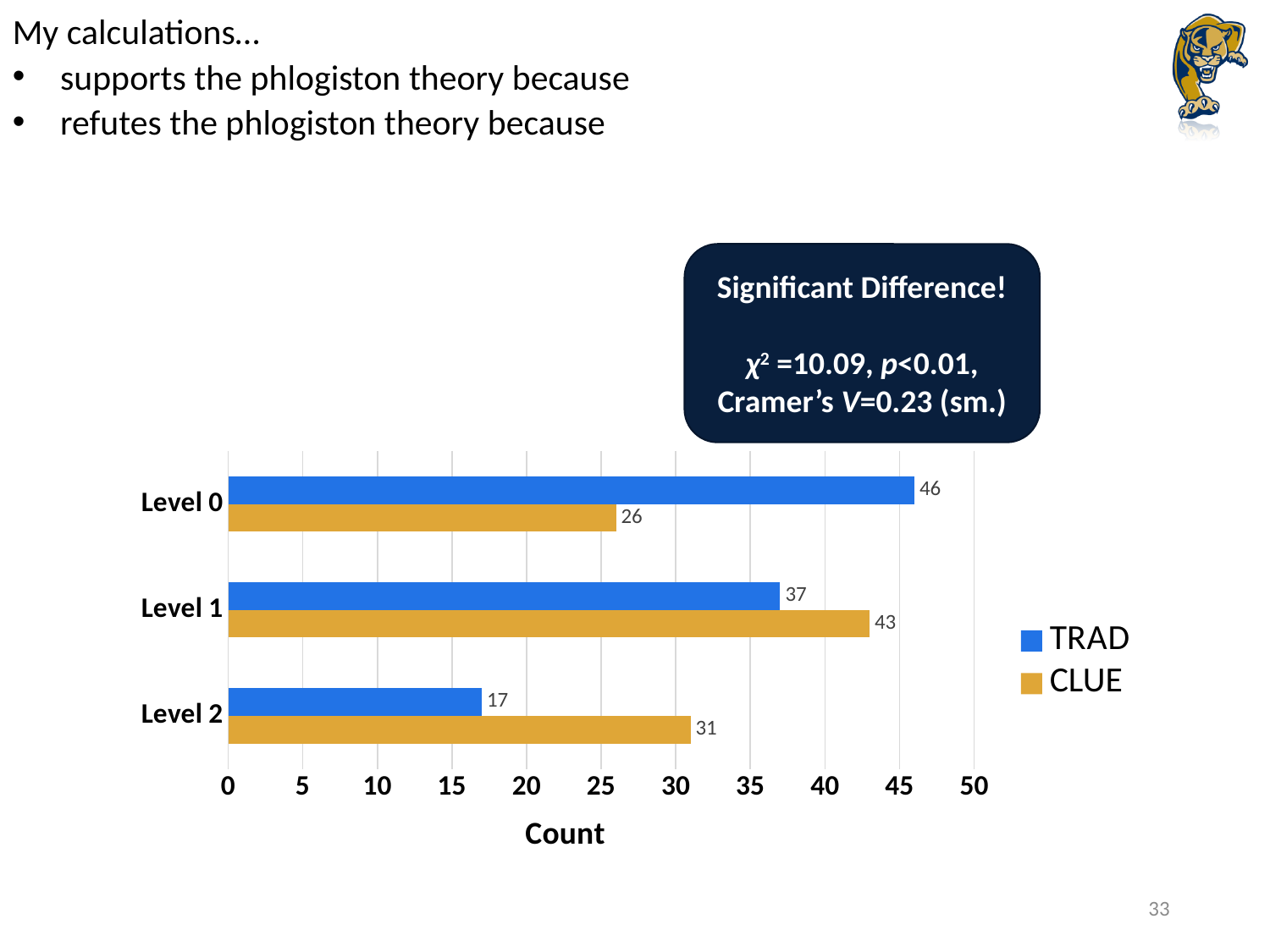
What is the difference between the TRAD and CLUE counts for Level 0? 20 What is the TRAD count for Level 0? 46 Which level has the highest TRAD count? Level 0 What is the CLUE count for Level 2? 31 How many levels are shown on the chart? 3 For Level 1, which series has the larger count, TRAD or CLUE? CLUE What kind of chart is shown on the slide? bar chart What is the CLUE count for Level 1? 43 What is the label of the horizontal axis? Count How many series does the legend list? 2 Is the TRAD count for Level 2 greater or less than 20? less Which level has the lowest CLUE count? Level 0